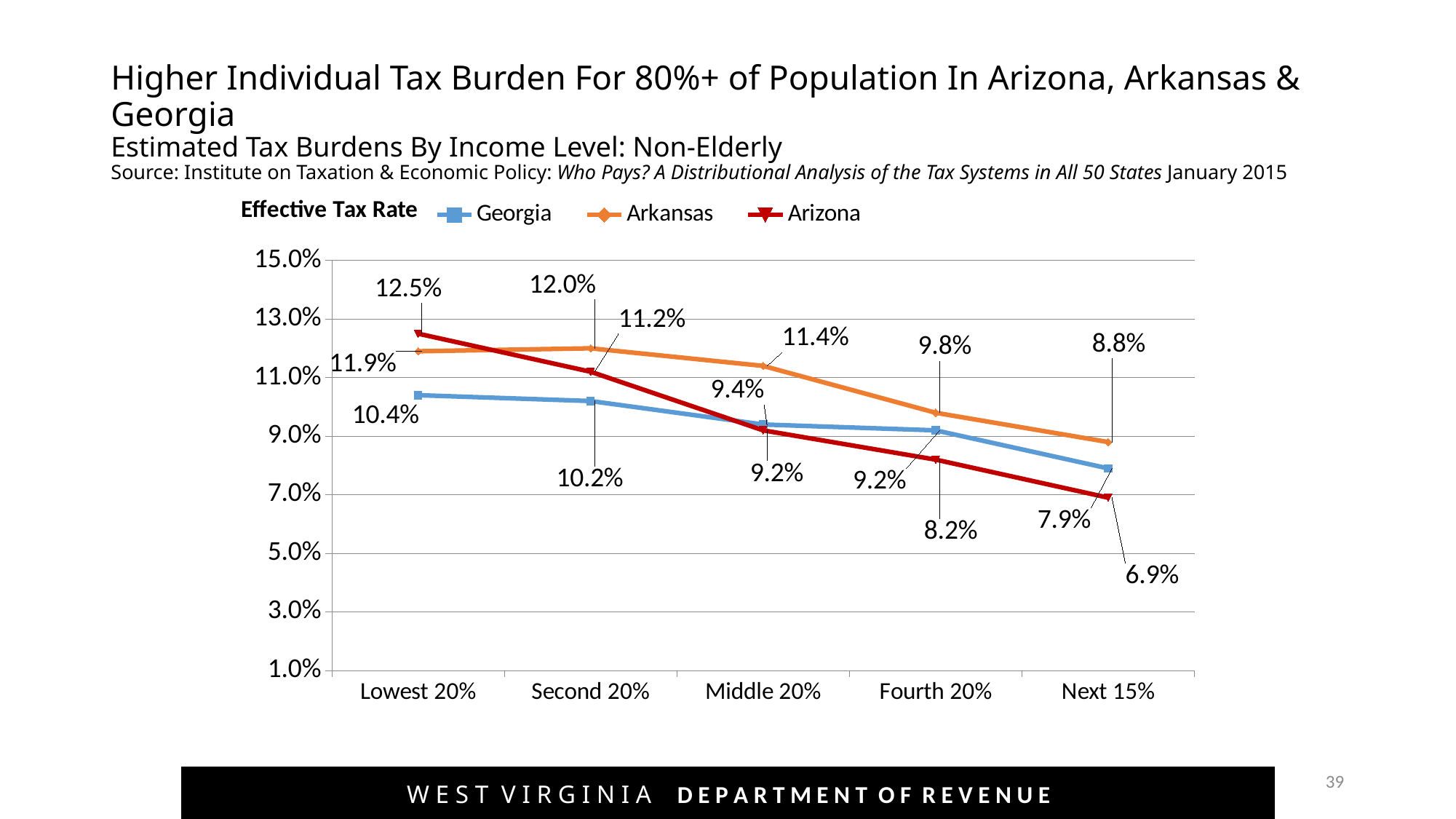
Which state has the lowest effective tax rate at the Next 15% income level? Arizona What kind of chart is shown on the slide? Line chart What is the axis title shown above the chart next to the legend? Effective Tax Rate Does the Arizona effective tax rate rise or fall from the Lowest 20% to the Next 15% income level? Fall What is the effective tax rate for Georgia at the Next 15% income level? 7.9% Which state has the highest effective tax rate at the Lowest 20% income level? Arizona How many series does the legend list? 3 At the Second 20% income level, which is higher: the Arkansas rate or the Arizona rate? Arkansas How many income level categories are shown on the x axis? 5 What is the difference between the Arkansas and Georgia effective tax rates at the Fourth 20% income level? 0.6% What is the effective tax rate for Arkansas at the Middle 20% income level? 11.4% What is the effective tax rate for Arizona at the Lowest 20% income level? 12.5%